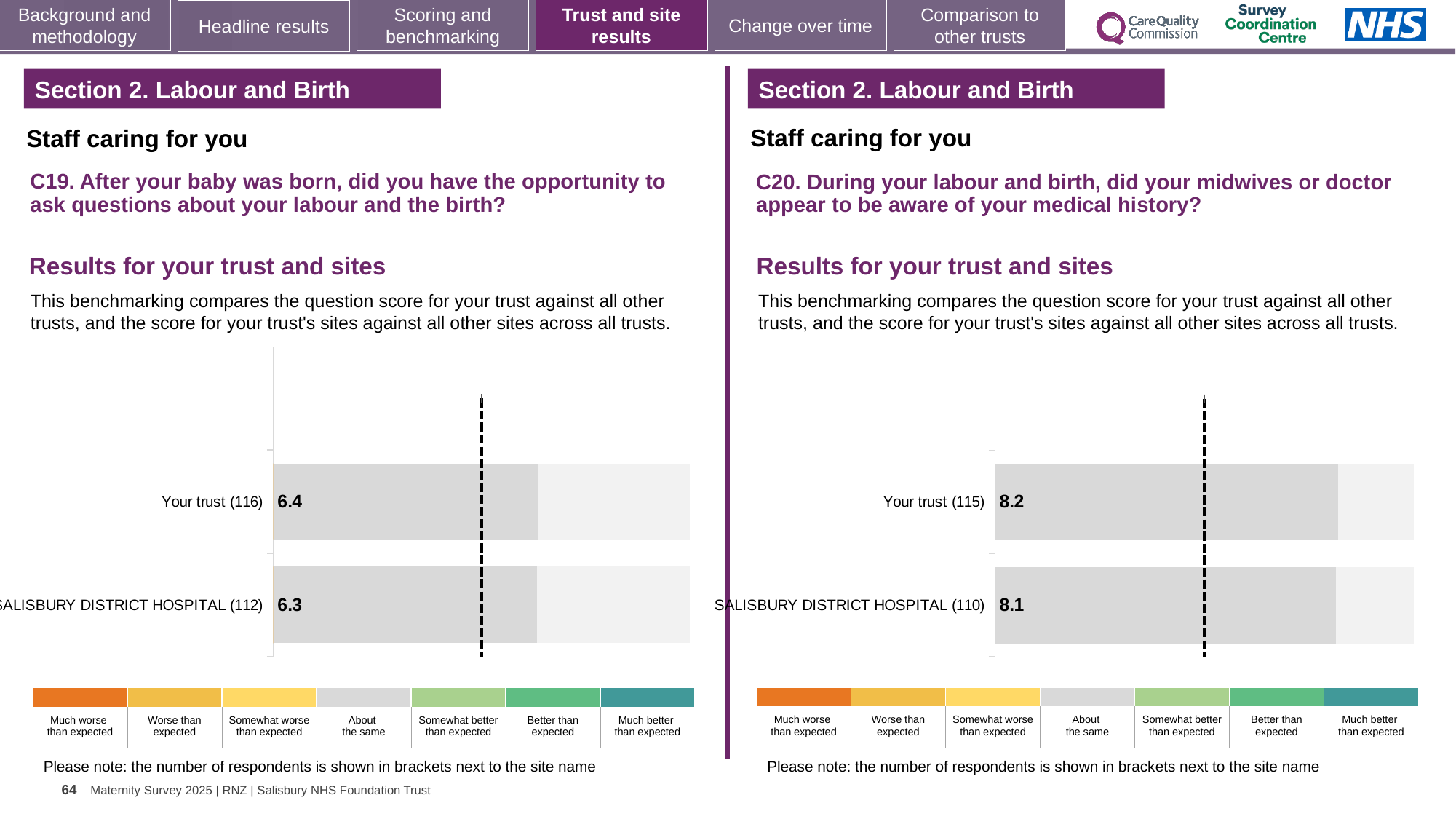
In the C20 chart, what is the score for Your trust? 8.2 In the C19 chart, how many respondents are shown in brackets for Your trust? 116 How many benchmark categories does the legend below the C19 chart list? 7 Which is higher: the Your trust score in the C19 chart or the Your trust score in the C20 chart? C20 (8.2) In the C19 chart, what is the score for Your trust? 6.4 In the C19 chart, what is the difference between the Your trust score and the SALISBURY DISTRICT HOSPITAL score? 0.1 In the C19 chart, what is the score for SALISBURY DISTRICT HOSPITAL? 6.3 How many bars are plotted in the C19 chart? 2 In the C20 chart, what is the difference between the Your trust score and the SALISBURY DISTRICT HOSPITAL score? 0.1 In the C20 chart, what is the score for SALISBURY DISTRICT HOSPITAL? 8.1 In the C20 chart, how many respondents are shown in brackets for SALISBURY DISTRICT HOSPITAL? 110 What type of chart is used for the C20 results? Bar chart